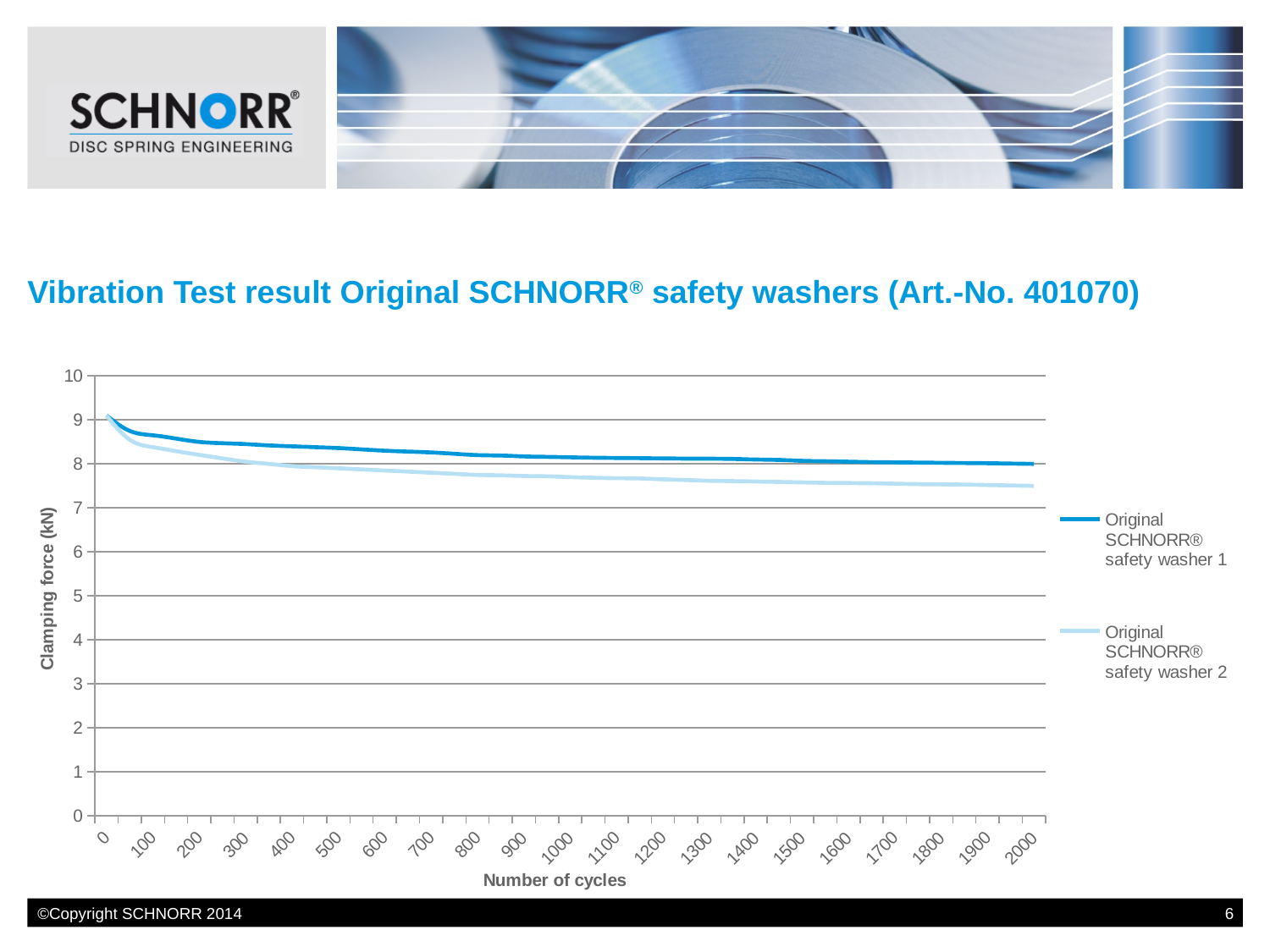
What is the label of the vertical axis? Clamping force (kN) Is the clamping force for Original SCHNORR® safety washer 2 at 2000 cycles greater or less than 7? greater How many tick labels are shown on the Number of cycles axis? 21 What is the title of the chart on the slide? Vibration Test result Original SCHNORR® safety washers (Art.-No. 401070) Does the clamping force for Original SCHNORR® safety washer 2 rise or fall as the number of cycles increases? fall At 1000 cycles, which series has the higher clamping force, Original SCHNORR® safety washer 1 or Original SCHNORR® safety washer 2? Original SCHNORR® safety washer 1 Does the clamping force for Original SCHNORR® safety washer 1 rise or fall as the number of cycles increases? fall How many series does the legend list? 2 What kind of chart is shown on the slide? line chart Is the clamping force for Original SCHNORR® safety washer 1 at 500 cycles greater or less than 8? greater Is the clamping force for Original SCHNORR® safety washer 2 at 2000 cycles greater or less than 8? less